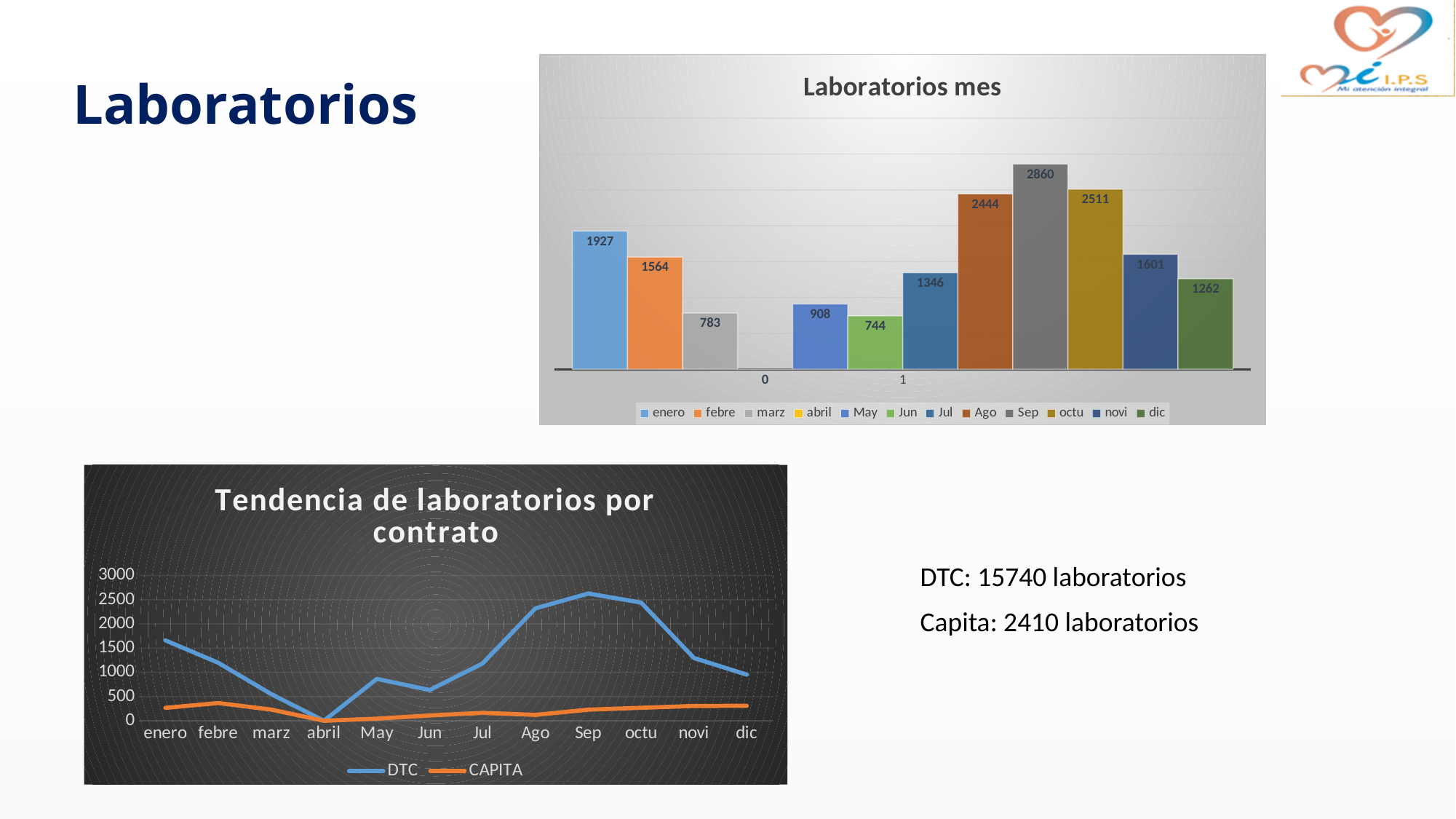
In the 'Laboratorios mes' chart, what is the difference between the values for Sep and Ago? 416 What kind of chart is 'Laboratorios mes'? Bar chart In the 'Tendencia de laboratorios por contrato' chart, does the DTC line rise or fall from Sep to dic? fall In the 'Tendencia de laboratorios por contrato' chart, how many series does the legend list? 2 In the 'Laboratorios mes' chart, what is the value for Sep? 2860 In the 'Tendencia de laboratorios por contrato' chart, is the CAPITA value for dic greater or less than 500? less In the 'Laboratorios mes' chart, how many months does the legend list? 12 In the 'Laboratorios mes' chart, what is the value for enero? 1927 In the 'Laboratorios mes' chart, which is larger, the value for febre or the value for novi? novi In the 'Laboratorios mes' chart, which month with a labeled bar has the lowest value? Jun In the 'Tendencia de laboratorios por contrato' chart, is the DTC value for Sep greater or less than 2500? greater In the 'Laboratorios mes' chart, which month has the highest value? Sep